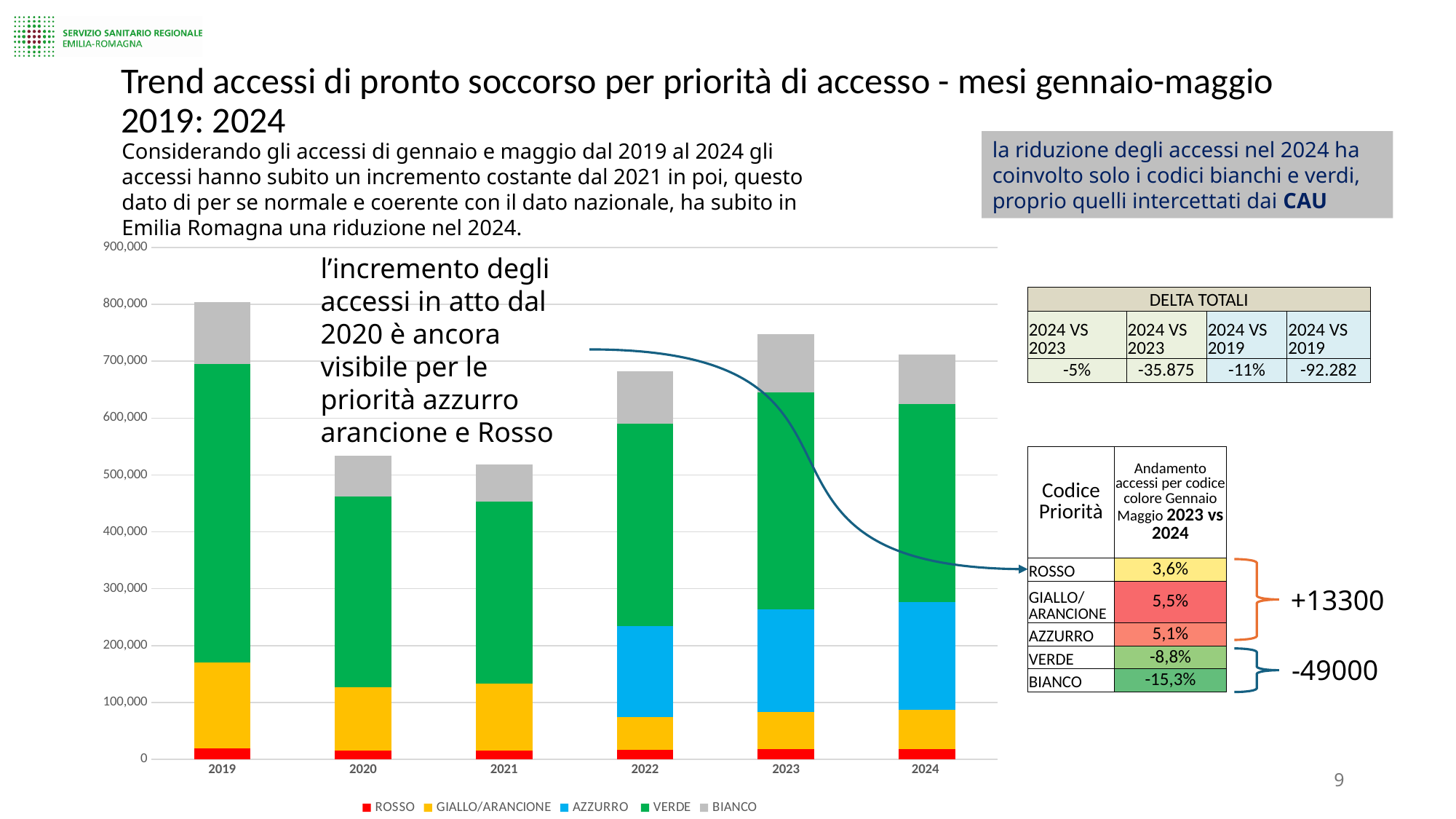
Is the total bar for 2020 greater or less than 600,000? less Do the total bars rise or fall from 2021 to 2023? rise Which series is shown at the bottom of each stacked bar? ROSSO How many series does the chart legend list? 5 Is the total bar for 2022 greater or less than 600,000? greater Is the total bar for 2024 greater or less than 800,000? less Which year has the larger total bar, 2023 or 2024? 2023 Which year has the highest total bar in the chart? 2019 What kind of chart is shown on the slide? stacked bar chart How many years are shown on the x axis of the chart? 6 In which year does the AZZURRO series first appear in the stacked bars? 2022